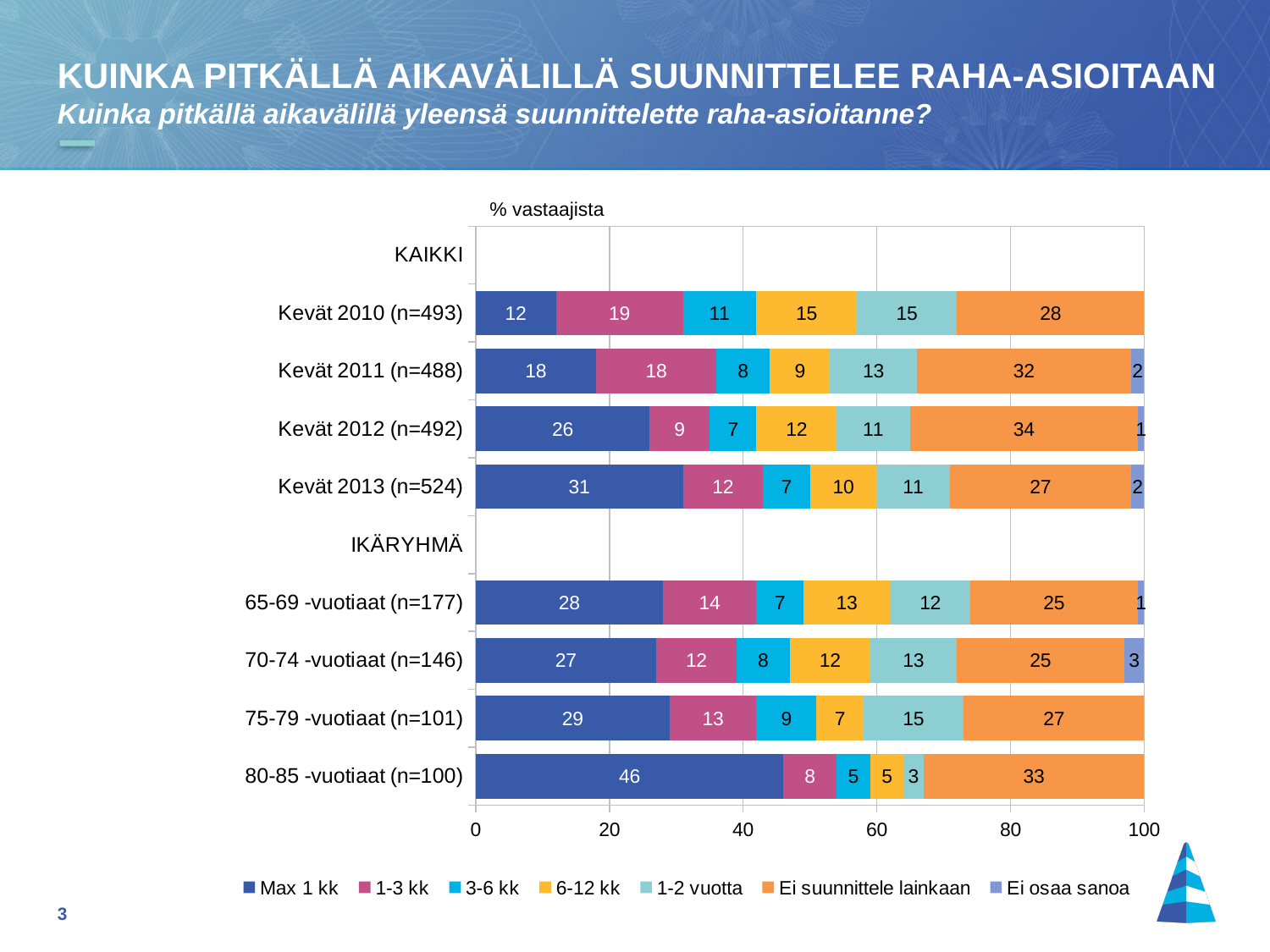
Which category has the lowest value for 'Max 1 kk'? Kevät 2010 (n=493) How many bars are plotted in the chart? 8 Which category has the highest value for 'Max 1 kk'? 80-85 -vuotiaat (n=100) What is the total of the Kevät 2011 (n=488) stacked bar? 100 What label is shown above the chart to indicate the unit of the values? % vastaajista Does the 'Max 1 kk' value rise or fall from Kevät 2010 to Kevät 2013? Rise What is the difference between the 'Max 1 kk' values for Kevät 2013 (n=524) and Kevät 2010 (n=493)? 19 What is the value for 'Ei suunnittele lainkaan' in the 80-85 -vuotiaat (n=100) bar? 33 How many series does the legend list? 7 Which is larger: the 'Ei suunnittele lainkaan' value for Kevät 2012 (n=492) or for Kevät 2013 (n=524)? Kevät 2012 (n=492) What kind of chart is shown on the slide? Stacked bar chart What is the value for 'Max 1 kk' in the Kevät 2013 (n=524) bar? 31